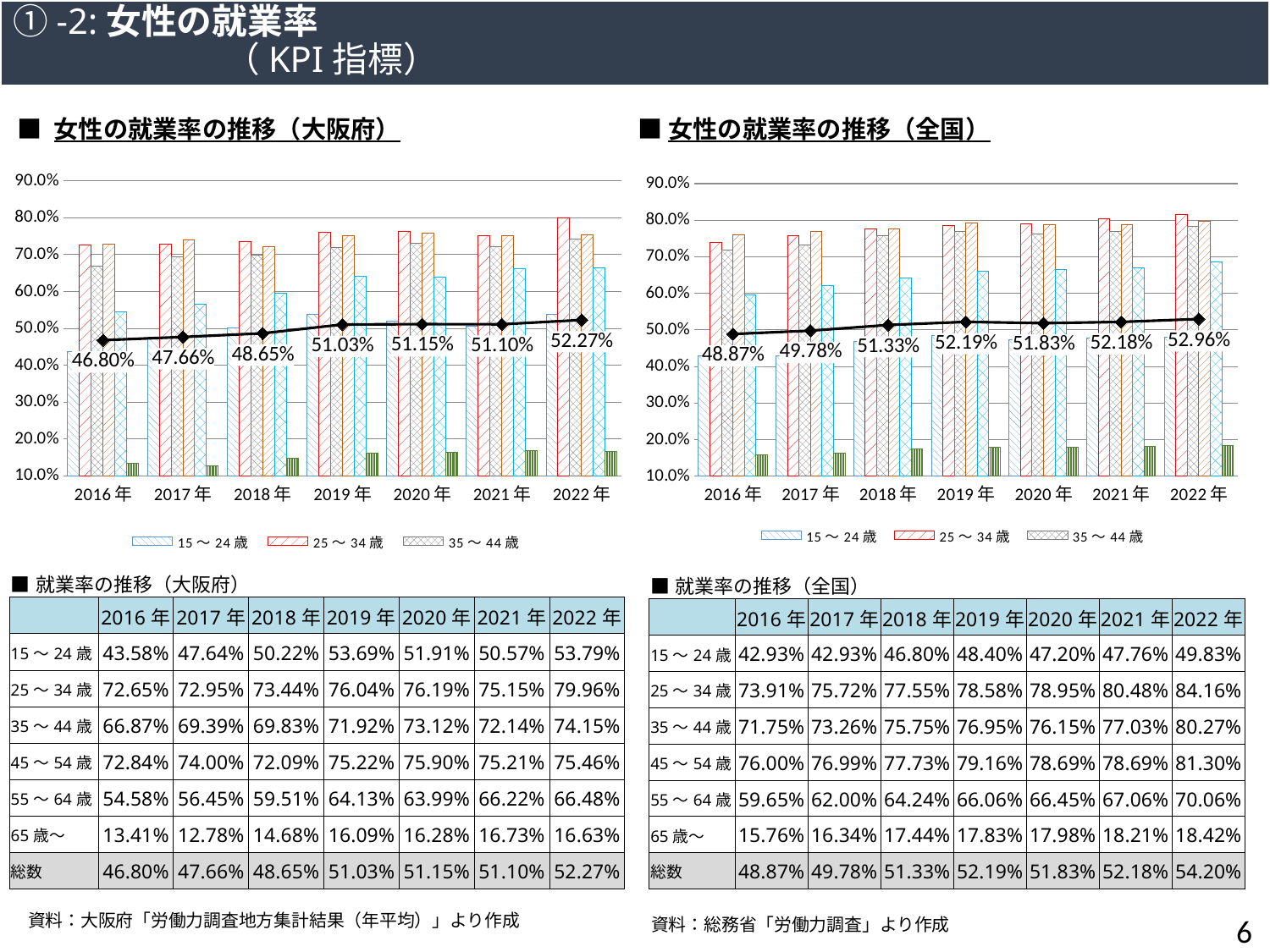
In the chart titled 女性の就業率の推移（大阪府）, which year has the larger labelled line value, 2020年 or 2021年? 2020年 In the chart titled 女性の就業率の推移（大阪府）, what value is labelled on the line for 2022年? 52.27% In the chart titled 女性の就業率の推移（全国）, which year has the lowest labelled line value? 2016年 In the chart titled 女性の就業率の推移（全国）, what value is labelled on the line for 2019年? 52.19% In the chart titled 女性の就業率の推移（大阪府）, how many years are shown on the x axis? 7 In the chart titled 女性の就業率の推移（大阪府）, which year has the highest labelled line value? 2022年 In the chart titled 女性の就業率の推移（大阪府）, is the 25～34歳 bar for 2022年 greater or less than 70.0%? greater In the chart titled 女性の就業率の推移（大阪府）, what value is labelled on the line for 2016年? 46.80% In the chart titled 女性の就業率の推移（全国）, what value is labelled on the line for 2016年? 48.87% What kind of chart is the chart titled 女性の就業率の推移（全国）? Combined bar and line chart In the chart titled 女性の就業率の推移（大阪府）, what is the difference between the labelled line values for 2022年 and 2016年? 5.47 percentage points In the chart titled 女性の就業率の推移（全国）, what is the difference between the labelled line values for 2019年 and 2016年? 3.32 percentage points